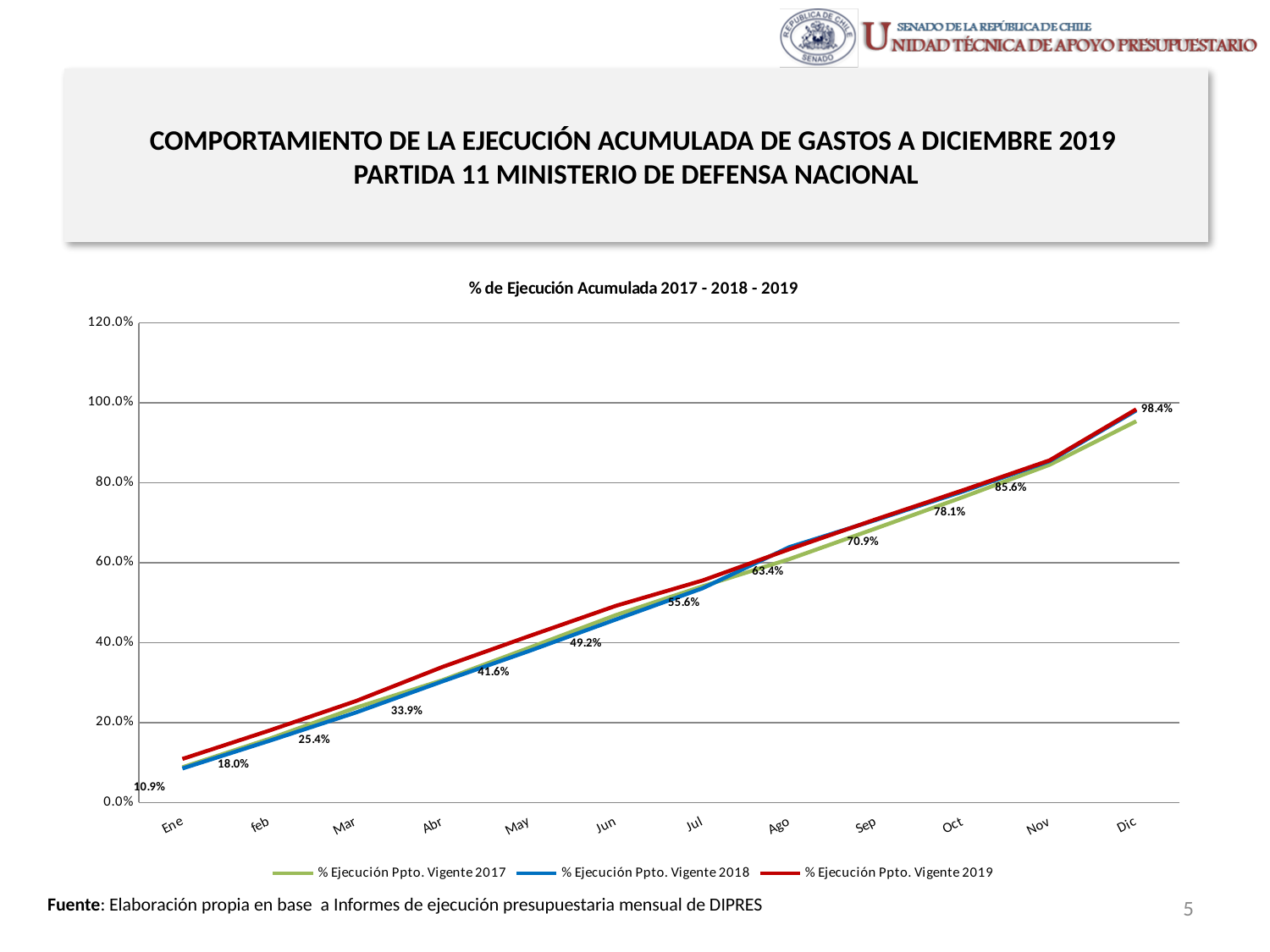
Is the value for % Ejecución Ppto. Vigente 2017 in Dic greater or less than 100.0%? less Do the values of the % Ejecución Ppto. Vigente 2019 series rise or fall from Ene to Dic? rise How many months are plotted along the x axis? 12 What is the difference between the 2019 values for Dic and Nov? 12.8% What type of chart is shown on the slide? line chart In which month is the % Ejecución Ppto. Vigente 2019 series lowest? Ene What is the value for % Ejecución Ppto. Vigente 2019 in Jun? 49.2% How many series does the legend list? 3 What is the value for % Ejecución Ppto. Vigente 2019 in Ene? 10.9% What is the value for % Ejecución Ppto. Vigente 2019 in Dic? 98.4% In which month is the % Ejecución Ppto. Vigente 2019 series highest? Dic What is the value for % Ejecución Ppto. Vigente 2019 in Sep? 70.9%